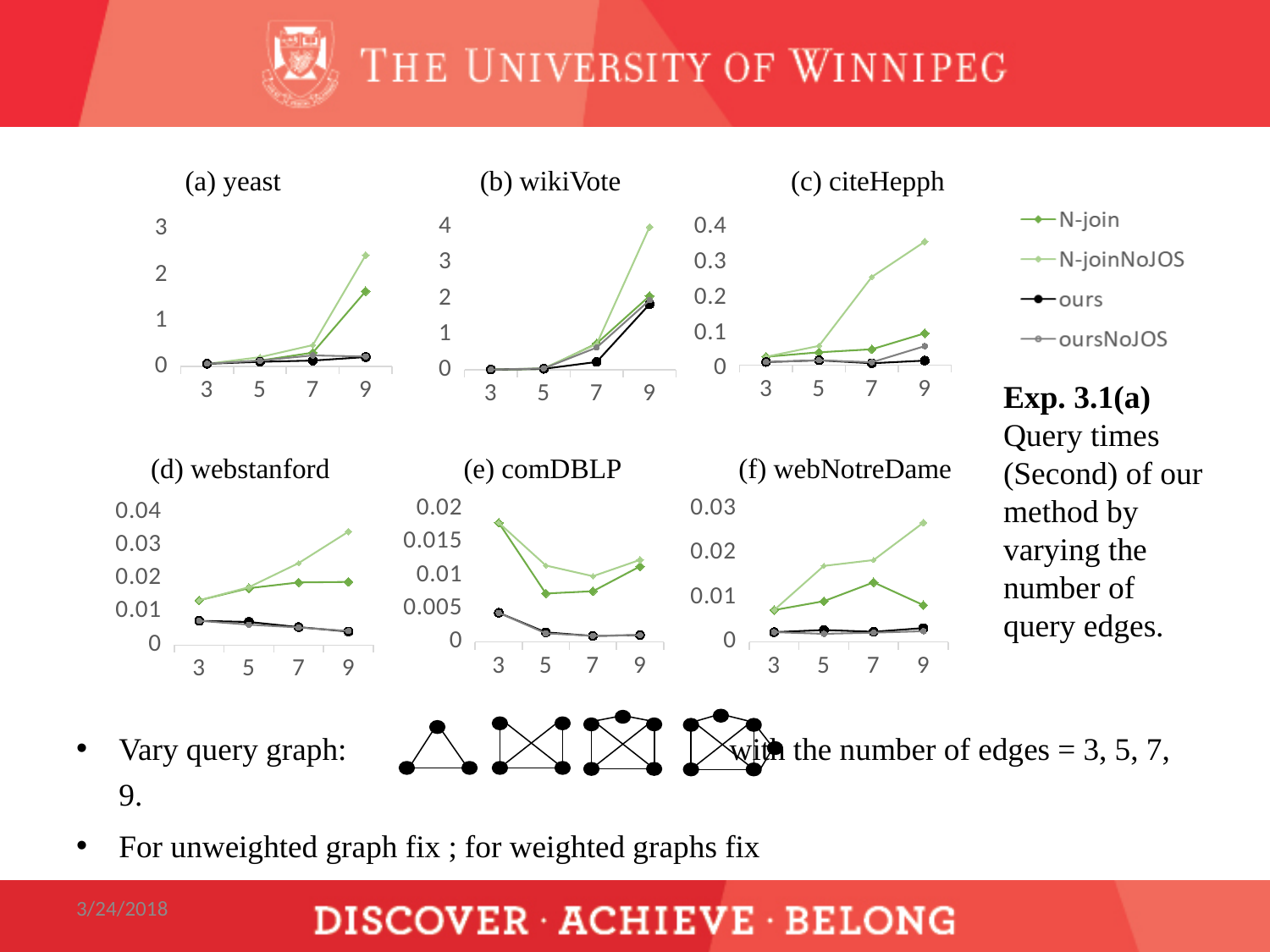
In chart (c) citeHepph, is the value of N-joinNoJOS at 9 edges greater or less than 0.3? greater In chart (f) webNotreDame, at which number of edges does the N-join series reach its highest value? 7 How many x-axis points (numbers of query edges) are plotted in chart (b) wikiVote? 4 In chart (a) yeast, is the value of N-joinNoJOS at 9 edges greater or less than 2? greater In chart (a) yeast, which series has the highest value at 9 edges? N-joinNoJOS How many series does the legend list for the charts on this slide? 4 How many charts are shown on the slide? 6 In chart (c) citeHepph, does the N-joinNoJOS series rise or fall as the number of edges increases from 3 to 9? rises In chart (b) wikiVote, which is larger at 9 edges: N-joinNoJOS or ours? N-joinNoJOS What kind of chart is chart (a) yeast? line chart In chart (d) webstanford, is the value of N-joinNoJOS at 9 edges greater or less than 0.03? greater